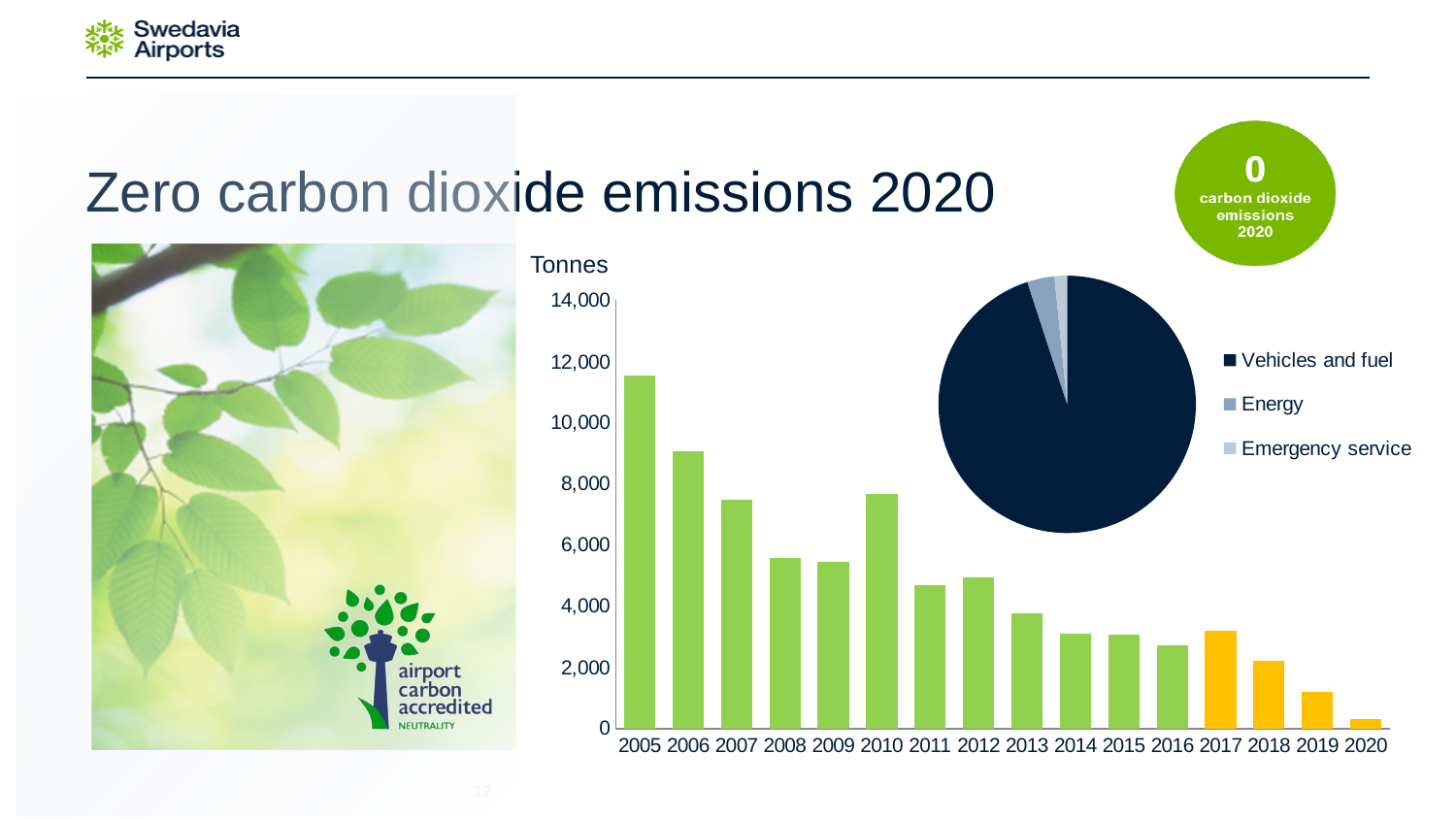
How many categories does the legend of the pie chart list? 3 In the pie chart, which category has the largest slice? Vehicles and fuel What kind of chart is the chart on the left showing emissions by year? Bar chart In the bar chart, which year has the larger value, 2006 or 2007? 2006 In the bar chart, how many years are shown on the x axis? 16 In the bar chart, which year has the larger value, 2010 or 2011? 2010 In the bar chart, is the value for 2005 greater or less than 10,000? greater In the bar chart, do emissions generally rise or fall from 2005 to 2020? Fall In the bar chart, is the value for 2010 greater or less than 6,000? greater In the bar chart, which year has the lowest emissions? 2020 In the bar chart, which year has the highest emissions? 2005 In the bar chart, is the value for 2019 greater or less than 2,000? less